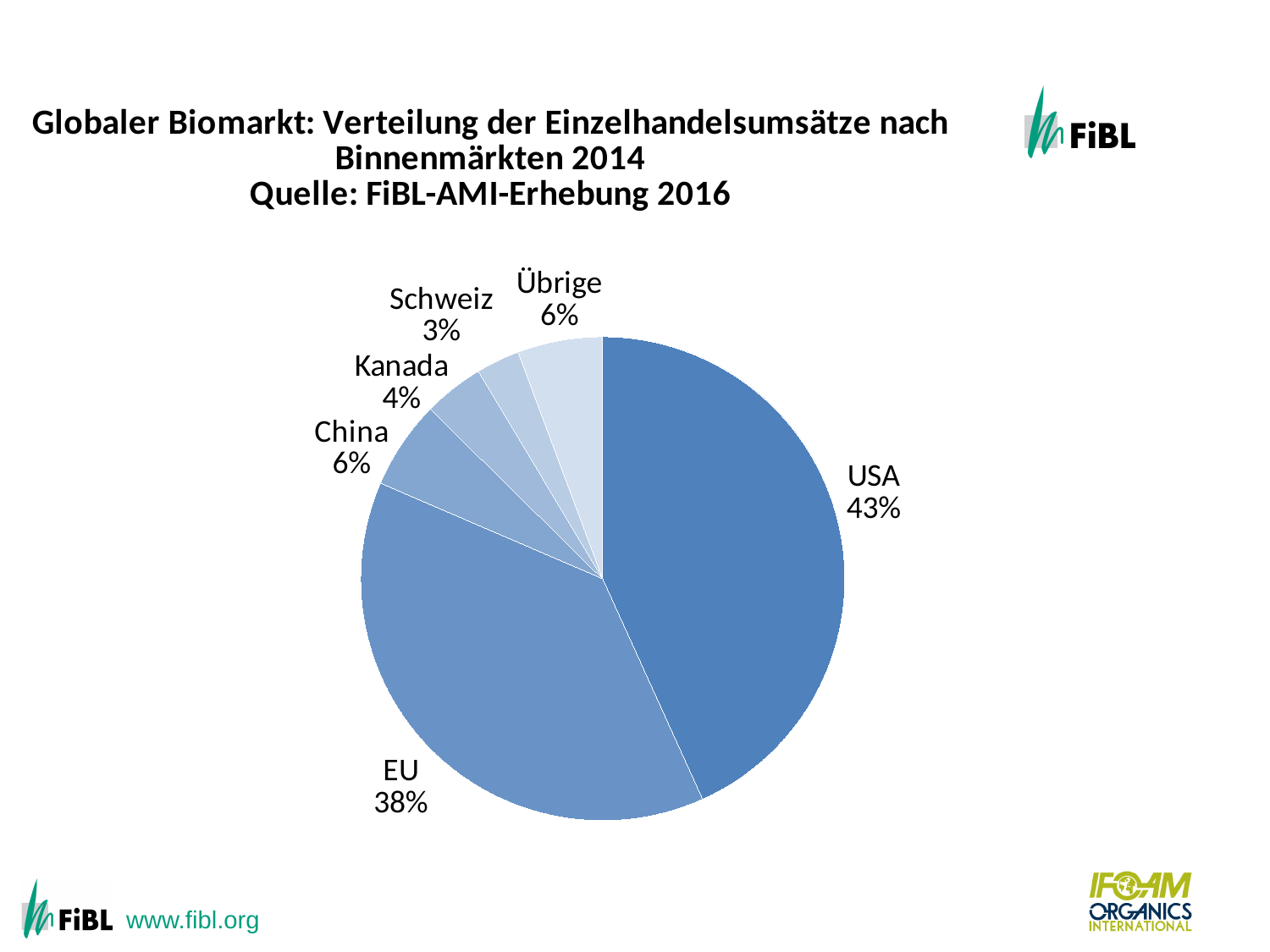
What share of the pie does the USA hold? 43% What kind of chart is shown on the slide? Pie chart What is the value shown for the EU? 38% Which is larger, the share for Kanada or the share for Schweiz? Kanada Which category has the largest slice of the pie? USA How many slices does the pie chart have? 6 What is the value shown for Kanada? 4% What is the difference between the USA share and the EU share? 5% What is the value shown for Schweiz? 3% What is the value shown for China? 6% What source is cited in the chart title? FiBL-AMI-Erhebung 2016 Which category has the smallest slice of the pie? Schweiz